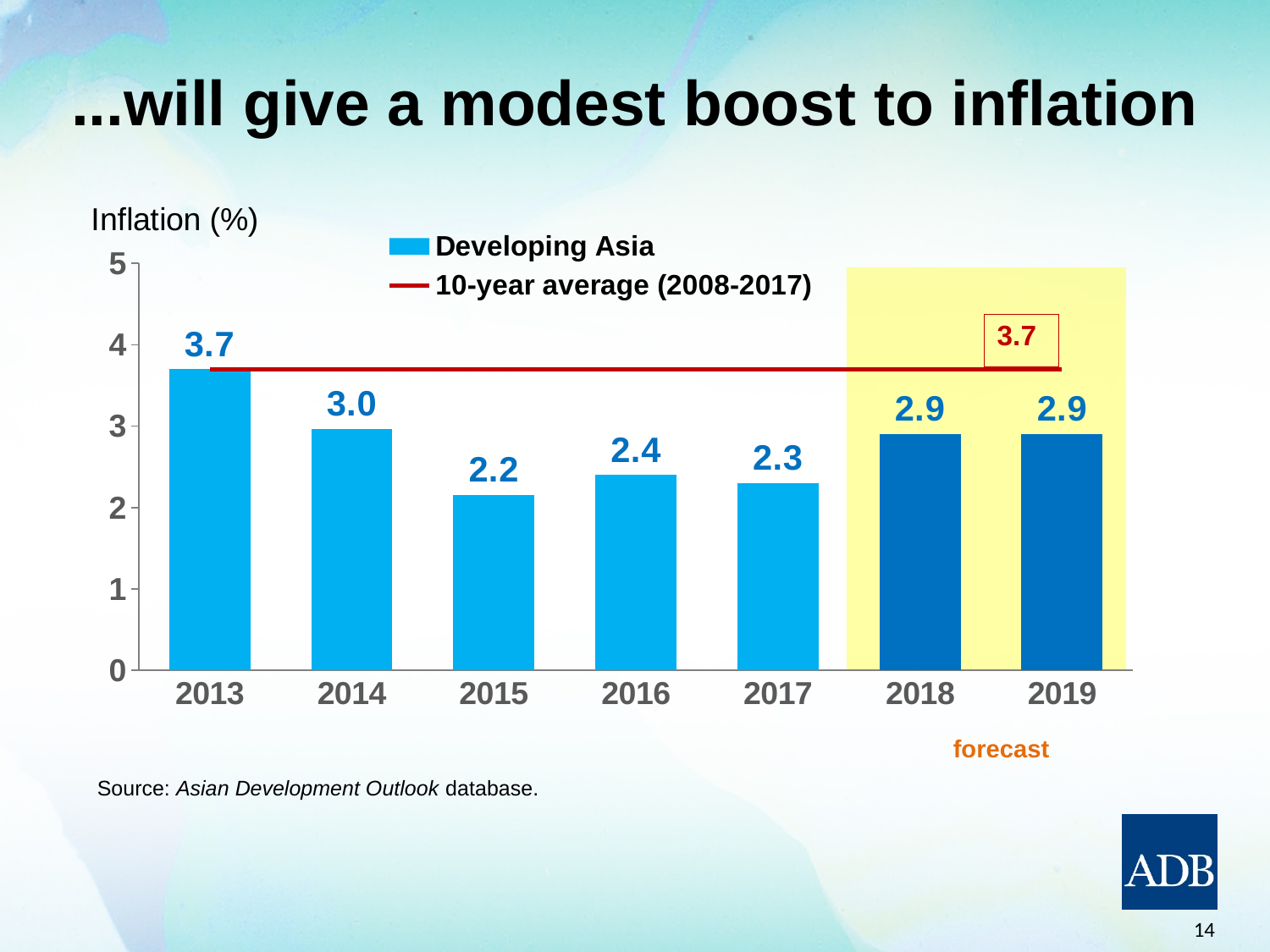
What is the difference between the inflation values for 2013 and 2017? 1.4 What is the inflation value for Developing Asia in 2018? 2.9 How many years are shown on the x axis of the chart? 7 What is the difference between the inflation values for 2014 and 2016? 0.6 What kind of chart is used to show Developing Asia inflation? Bar chart What is the value of the 10-year average (2008-2017) line? 3.7 Which years are marked as forecast on the chart? 2018 and 2019 What is the inflation value for Developing Asia in 2015? 2.2 Which year has the lowest inflation value for Developing Asia? 2015 Which year has the highest inflation value for Developing Asia? 2013 Which year has a higher inflation value, 2016 or 2017? 2016 How many series does the legend list? 2